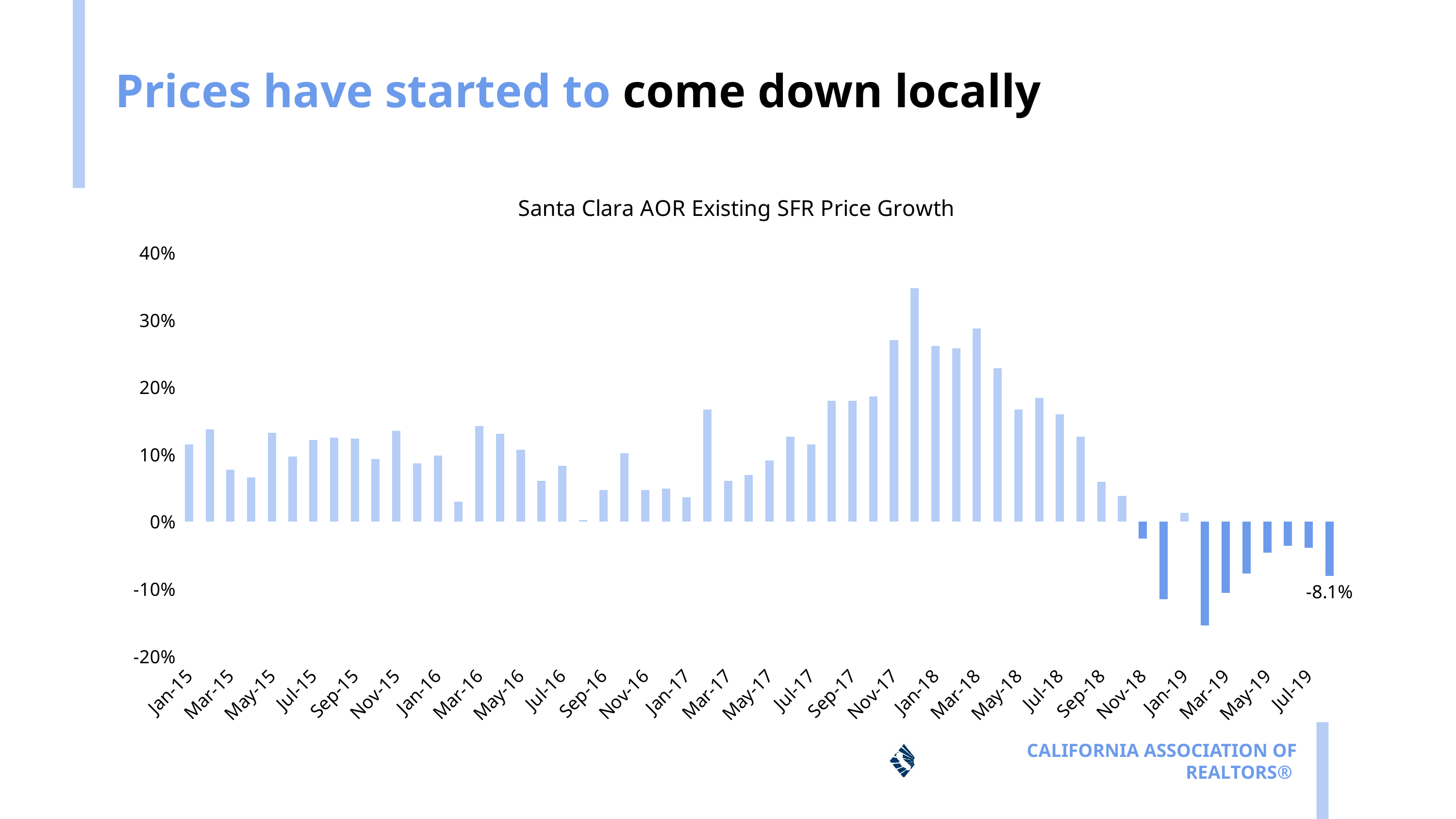
What is the title of the chart? Santa Clara AOR Existing SFR Price Growth Which is larger, the value for Jan-15 or the value for Mar-15? Jan-15 Is the value for Mar-18 greater or less than 20%? greater Which is larger, the value for Jan-18 or the value for Mar-18? Mar-18 What kind of chart is shown on the slide? bar chart Which month has the lowest price growth? Feb-19 Is the value for Nov-18 greater or less than 0%? less Which month has the highest price growth? Dec-17 Is the value for Jan-18 greater or less than 30%? less Do the values rise or fall from Jan-18 to Mar-19? fall